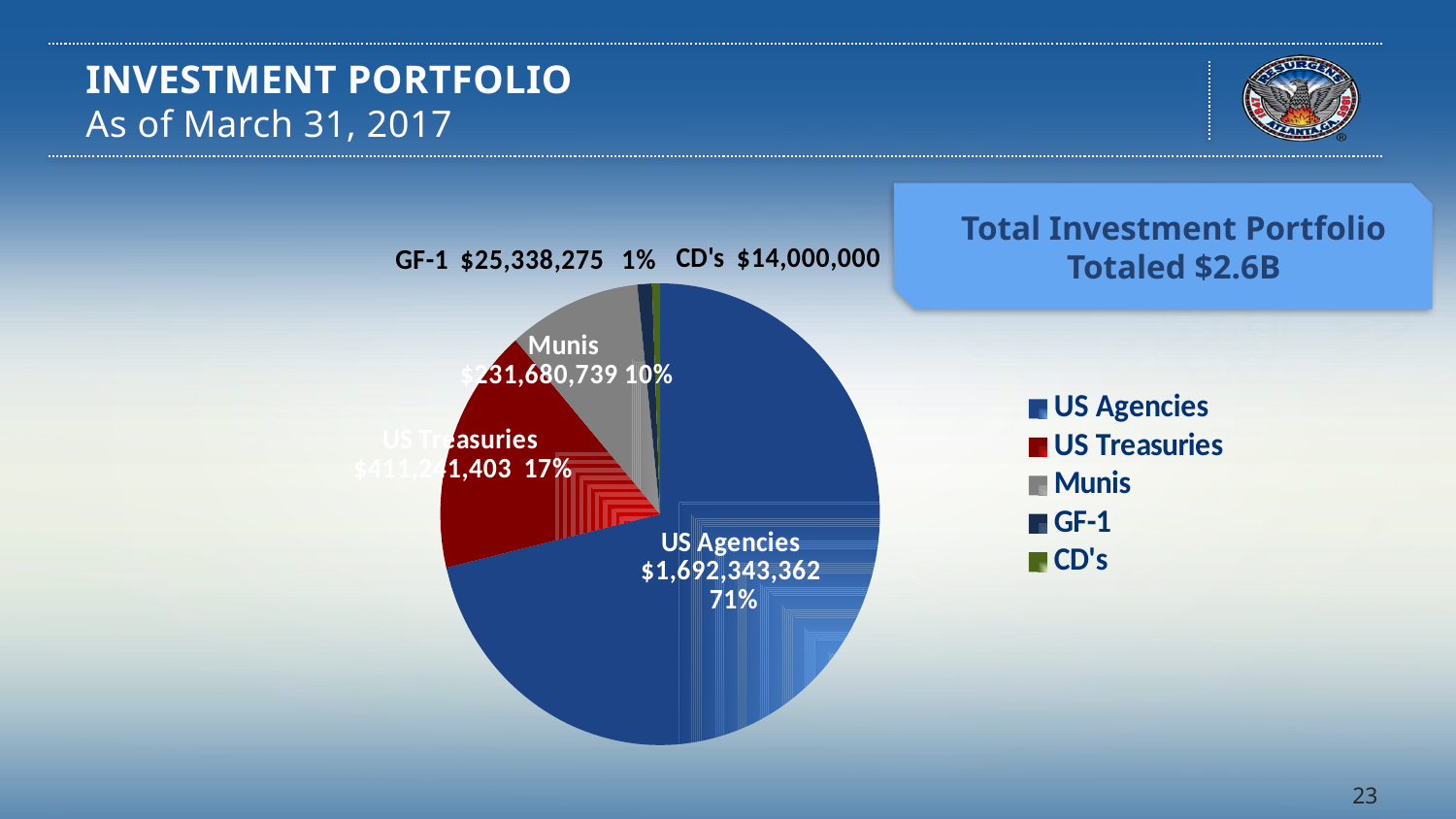
What is the value shown for GF-1 in the pie chart? $25,338,275 What is the difference between the GF-1 value and the CD's value in the pie chart? $11,338,275 What kind of chart is shown on the slide? Pie chart What is the value shown for CD's in the pie chart? $14,000,000 What percentage of the pie does US Agencies represent? 71% According to the callout box on the slide, what did the total investment portfolio total? $2.6B Which category has the smallest slice of the pie chart? CD's What is the value shown for US Agencies in the pie chart? $1,692,343,362 Which category has the largest slice of the pie chart? US Agencies How many slices does the pie chart have? 5 How many entries does the legend of the pie chart list? 5 Which is larger in the pie chart, US Treasuries or Munis? US Treasuries